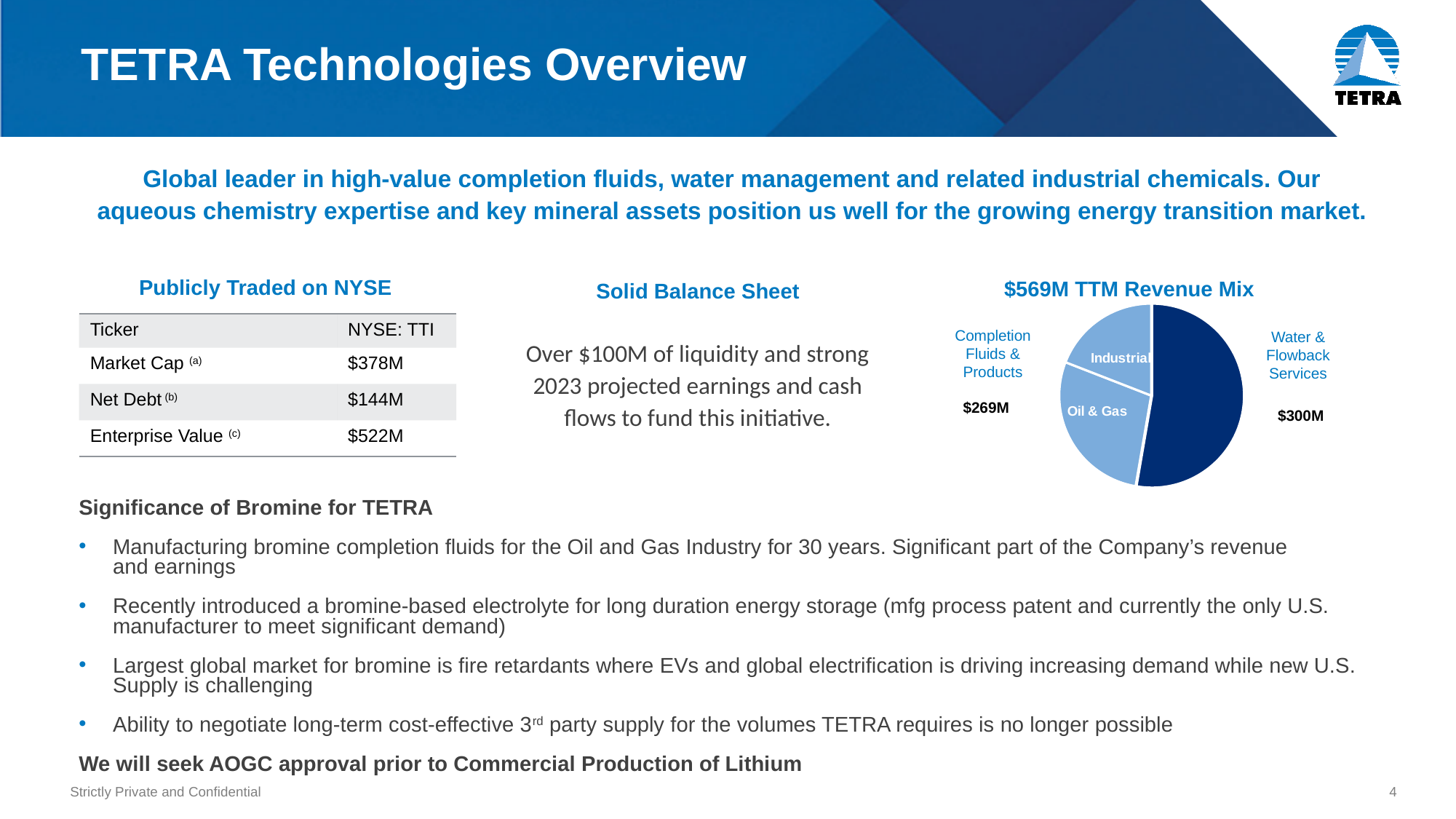
In the $569M TTM Revenue Mix pie chart, which slice is larger, Oil & Gas or Industrial? Oil & Gas In the $569M TTM Revenue Mix pie chart, which segment has the larger revenue, Water & Flowback Services or Completion Fluids & Products? Water & Flowback Services What is the total TTM revenue shown in the title of the pie chart? $569M What kind of chart is shown under the heading "$569M TTM Revenue Mix"? Pie chart What is the title of the pie chart on the slide? $569M TTM Revenue Mix In the $569M TTM Revenue Mix pie chart, what is the difference between the Water & Flowback Services revenue and the Completion Fluids & Products revenue? $31M In the $569M TTM Revenue Mix pie chart, which two slices together make up the Completion Fluids & Products segment? Industrial and Oil & Gas In the $569M TTM Revenue Mix pie chart, what is the revenue value for Water & Flowback Services? $300M In the $569M TTM Revenue Mix pie chart, what is the revenue value for Completion Fluids & Products? $269M How many slices are drawn in the $569M TTM Revenue Mix pie chart? 3